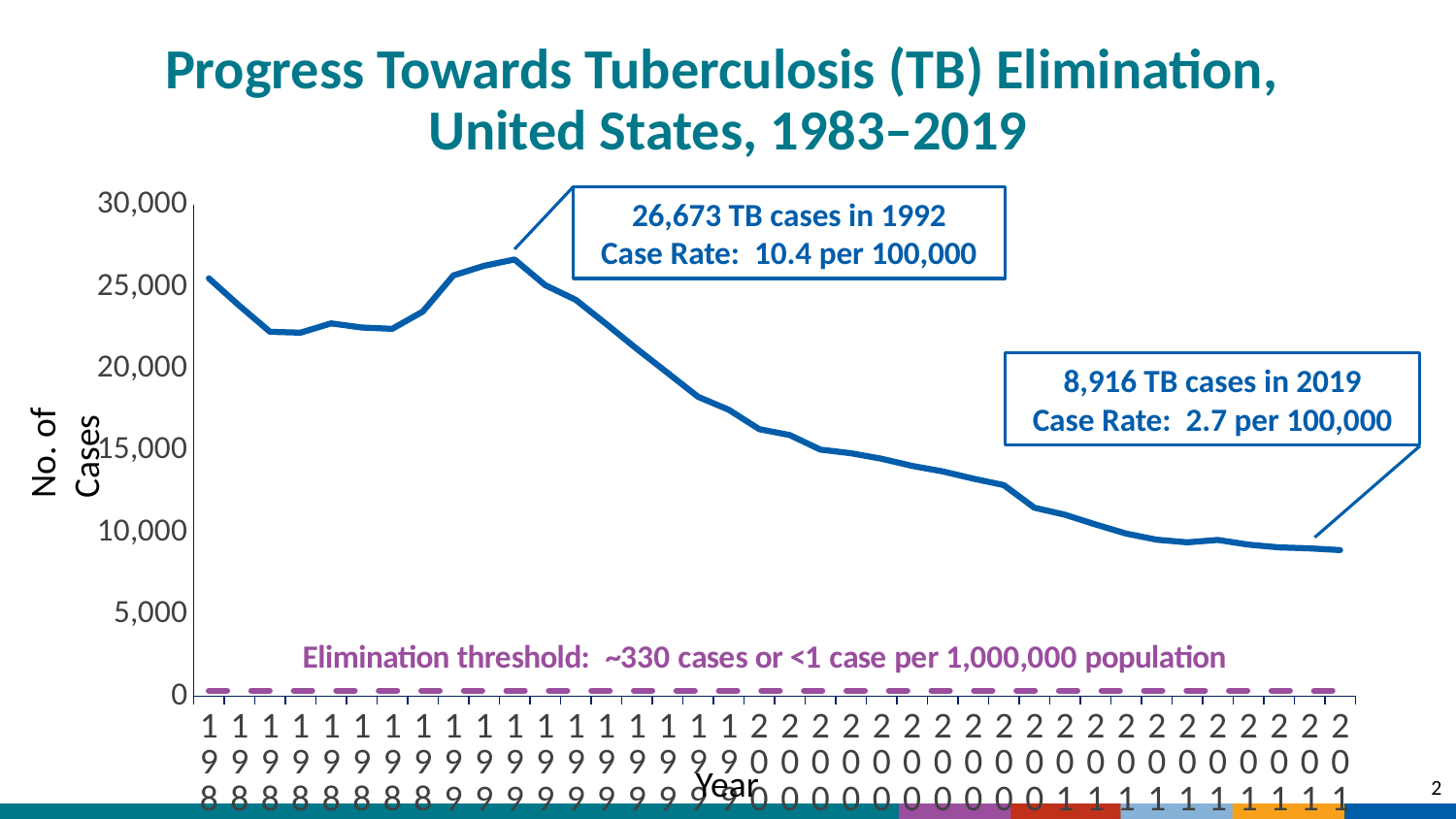
What is the title of the chart? Progress Towards Tuberculosis (TB) Elimination, United States, 1983–2019 What elimination threshold is shown by the dashed line on the chart? ~330 cases or <1 case per 1,000,000 population What was the TB case rate in 1992? 10.4 per 100,000 In which year does the line reach its highest number of TB cases? 1992 How many TB cases were reported in 2019 according to the chart annotation? 8,916 Do the number of TB cases rise or fall from 1992 to 2019? Fall What kind of chart is shown on the slide? Line chart Is the value for 2019 greater or less than 10,000? less Which year had more TB cases, 1992 or 2019? 1992 What is the difference between the number of TB cases in 1992 and in 2019? 17,757 How many TB cases were reported in 1992 according to the chart annotation? 26,673 What was the TB case rate in 2019? 2.7 per 100,000